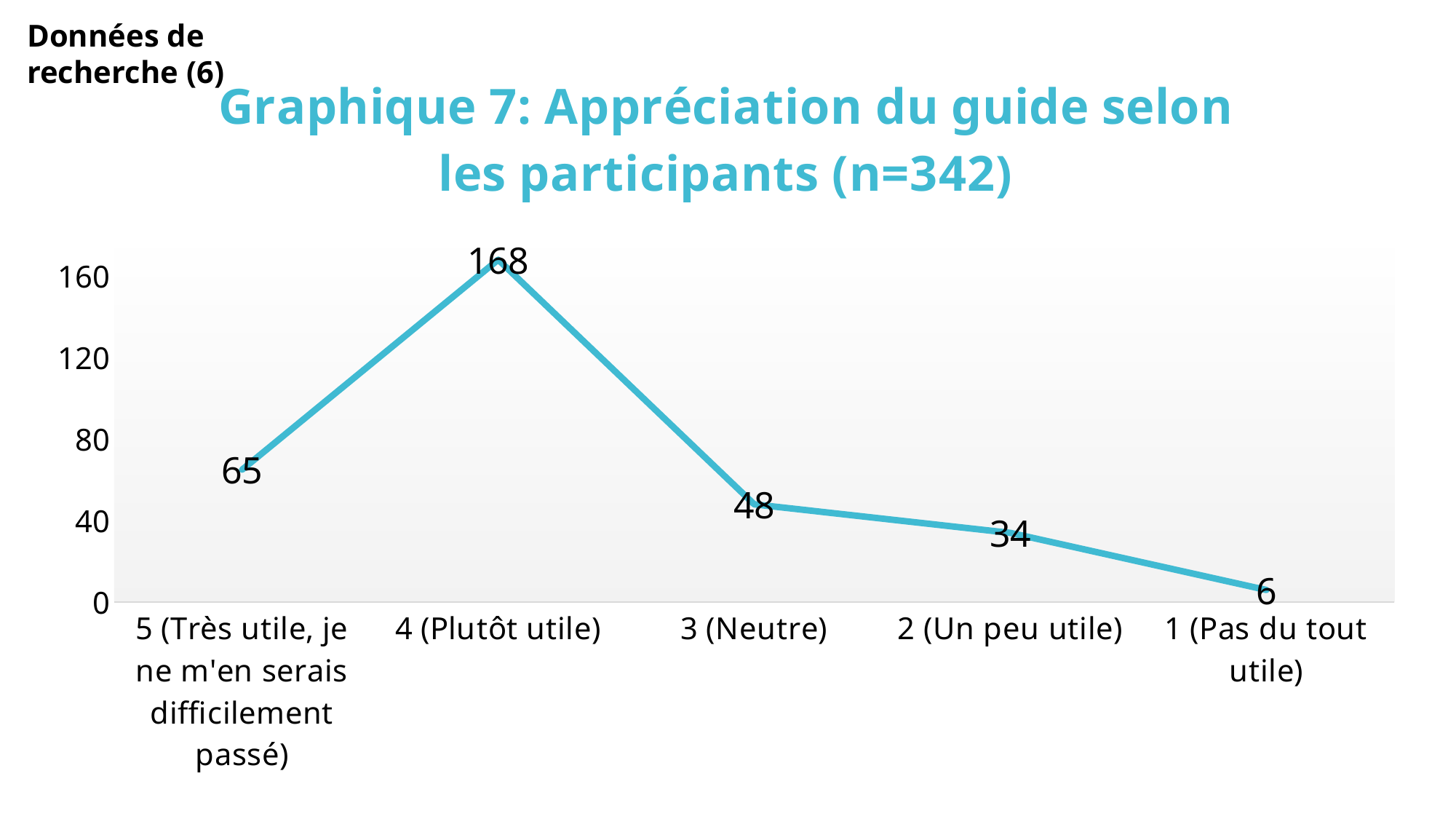
Which is larger, the value for "5 (Très utile, je ne m'en serais difficilement passé)" or the value for "3 (Neutre)"? 5 (Très utile, je ne m'en serais difficilement passé) What is the title of the chart? Graphique 7: Appréciation du guide selon les participants (n=342) How many categories are shown on the x axis? 5 What is the value for "2 (Un peu utile)"? 34 What kind of chart is shown on the slide? line chart Which category has the lowest value? 1 (Pas du tout utile) What is the value for "4 (Plutôt utile)"? 168 What is the difference between the values for "4 (Plutôt utile)" and "3 (Neutre)"? 120 What is the value for "3 (Neutre)"? 48 Is the value for "5 (Très utile, je ne m'en serais difficilement passé)" greater or less than 80? less What is the value for "1 (Pas du tout utile)"? 6 Which category has the highest value? 4 (Plutôt utile)